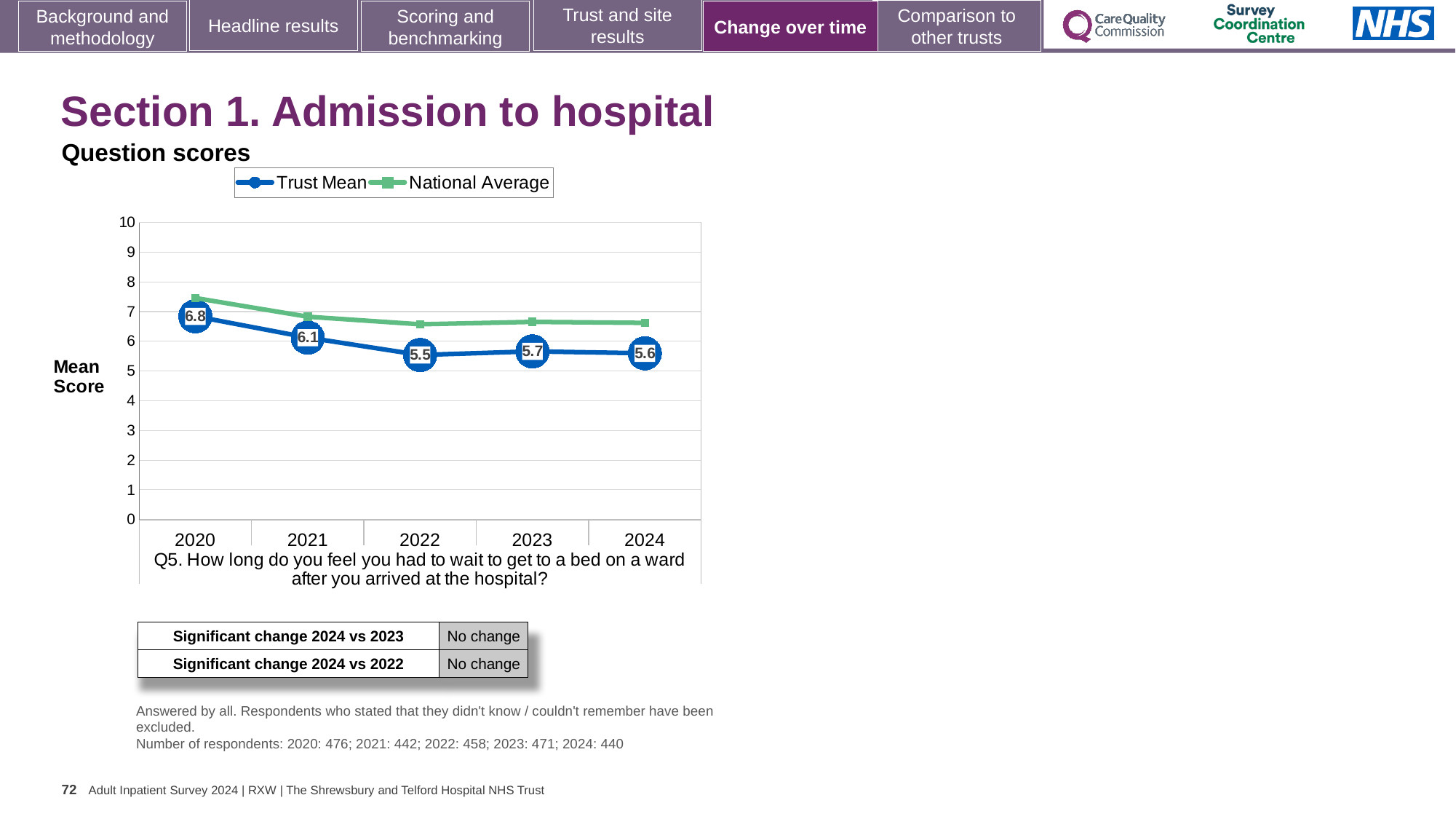
Which is larger, the Trust Mean score for 2021 or for 2023? 2021 What is the Trust Mean score for 2020? 6.8 What kind of chart is shown on the slide? line chart What is the difference between the Trust Mean scores for 2020 and 2021? 0.7 What is the Trust Mean score for 2024? 5.6 Does the Trust Mean score rise or fall from 2020 to 2022? fall How many years are plotted on the x axis? 5 Is the National Average value for 2020 greater or less than 7? greater What is the Trust Mean score for 2022? 5.5 How many series does the legend list? 2 In which year is the Trust Mean score lowest? 2022 In which year is the Trust Mean score highest? 2020